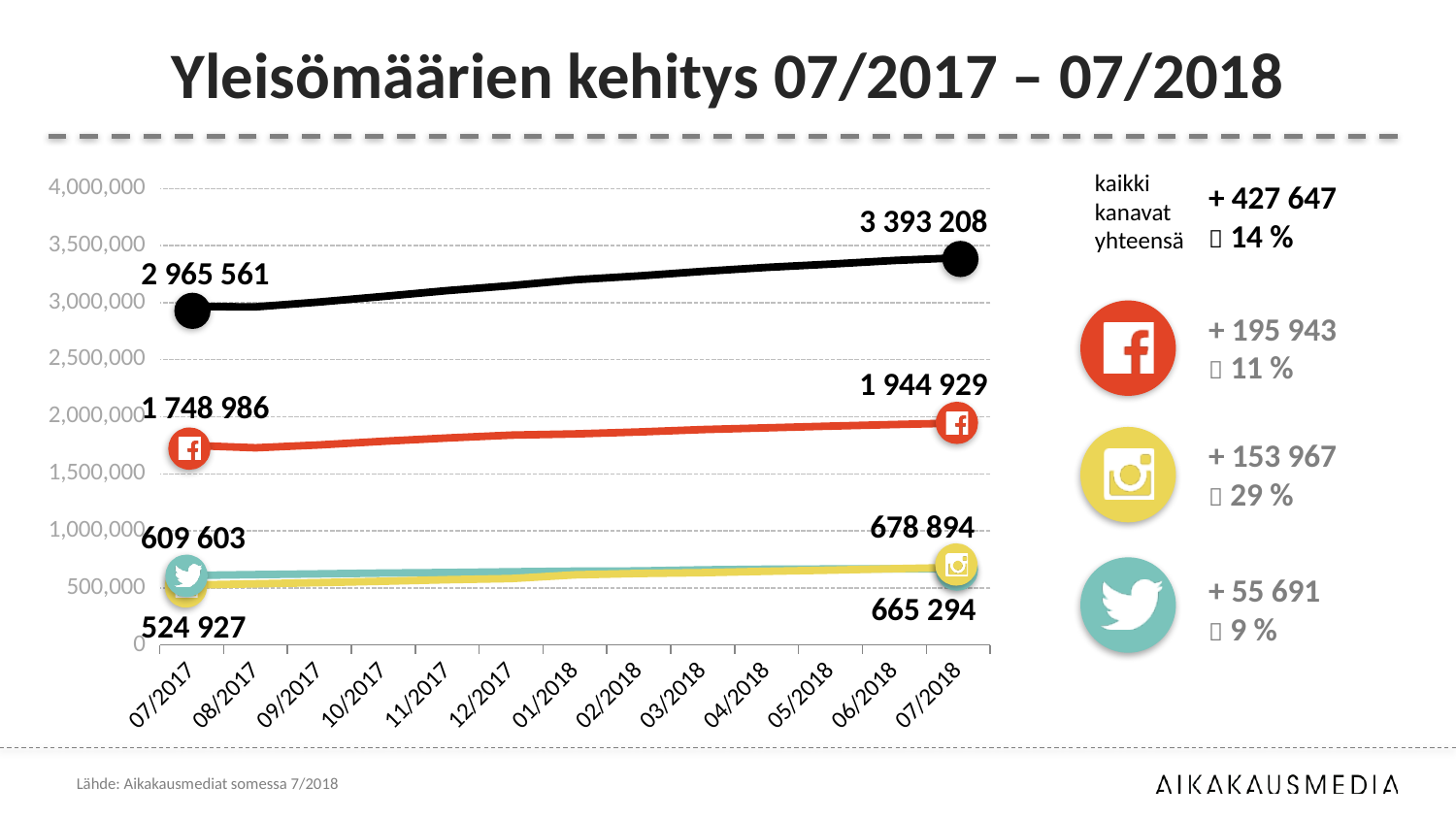
By how much did the red Facebook line increase from 07/2017 to 07/2018? 195 943 Does the black (total) line rise or fall from 07/2017 to 07/2018? rise What is the value of the red Facebook line at 07/2018? 1 944 929 At 07/2018, which is higher: the yellow Instagram line or the teal Twitter line? Instagram By how much did the yellow Instagram line increase from 07/2017 to 07/2018? 153 967 Is the value of the red Facebook line at 07/2018 greater or less than 2,000,000? less What is the value of the yellow Instagram line at 07/2017? 524 927 What is the value of the black (total) line at 07/2017? 2 965 561 What is the value of the teal Twitter line at 07/2018? 665 294 What is the value of the black (total) line at 07/2018? 3 393 208 What type of chart is shown on the slide? line chart How many months are shown on the x axis? 13